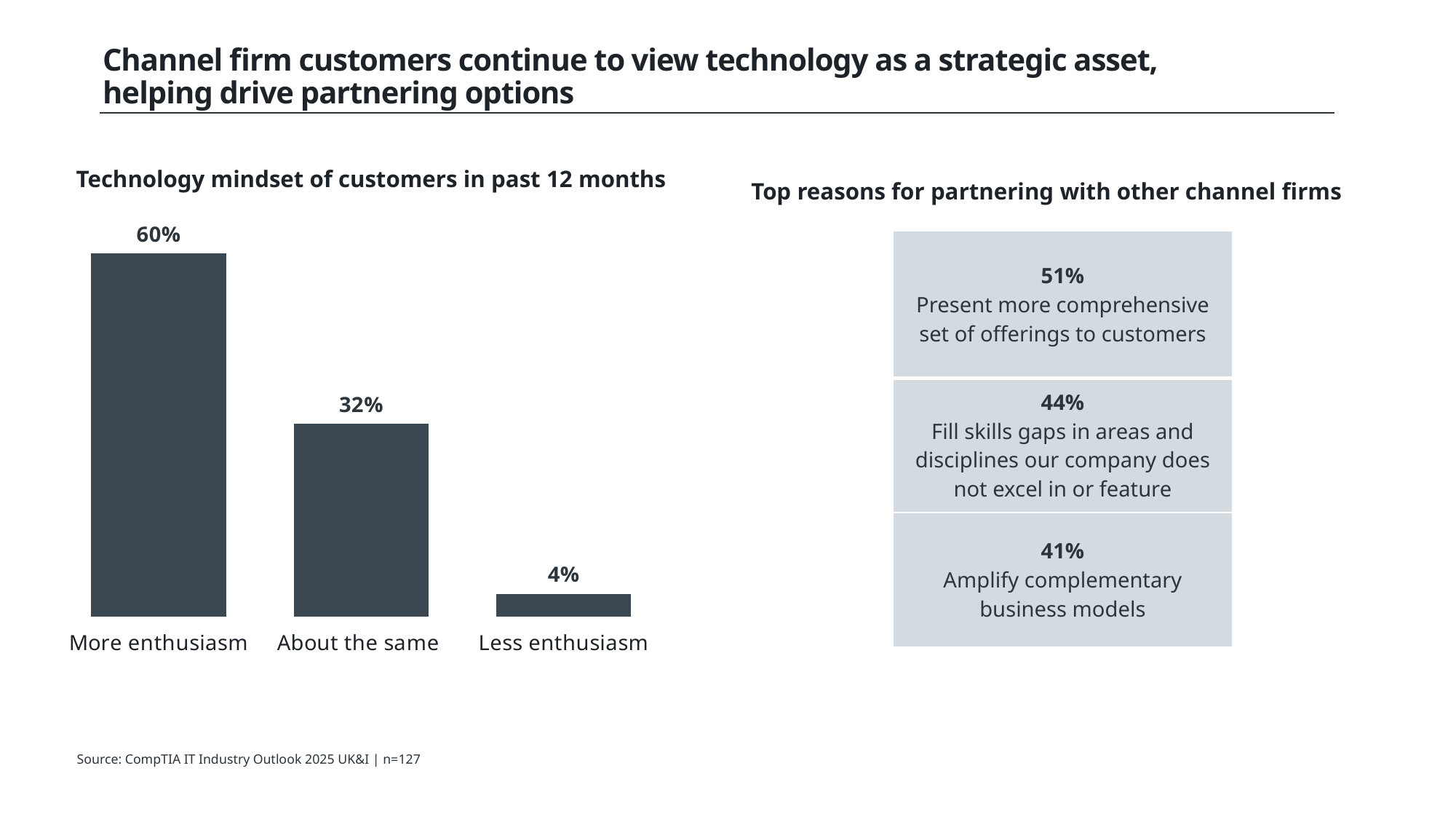
In the 'Technology mindset of customers in past 12 months' chart, what is the value for 'About the same'? 32% In the 'Technology mindset of customers in past 12 months' chart, what is the difference between 'More enthusiasm' and 'About the same'? 28% In the 'Technology mindset of customers in past 12 months' chart, do the values rise or fall from left to right? Fall In the 'Technology mindset of customers in past 12 months' chart, which is larger: 'About the same' or 'Less enthusiasm'? About the same In the 'Technology mindset of customers in past 12 months' chart, what is the value for 'More enthusiasm'? 60% In the 'Technology mindset of customers in past 12 months' chart, which category has the highest value? More enthusiasm In the 'Technology mindset of customers in past 12 months' chart, what is the value for 'Less enthusiasm'? 4% In the 'Technology mindset of customers in past 12 months' chart, which category has the lowest value? Less enthusiasm What kind of chart is 'Technology mindset of customers in past 12 months'? Bar chart In the 'Technology mindset of customers in past 12 months' chart, what is the difference between 'About the same' and 'Less enthusiasm'? 28% What is the title of the bar chart on the left of the slide? Technology mindset of customers in past 12 months How many categories are shown in the 'Technology mindset of customers in past 12 months' chart? 3